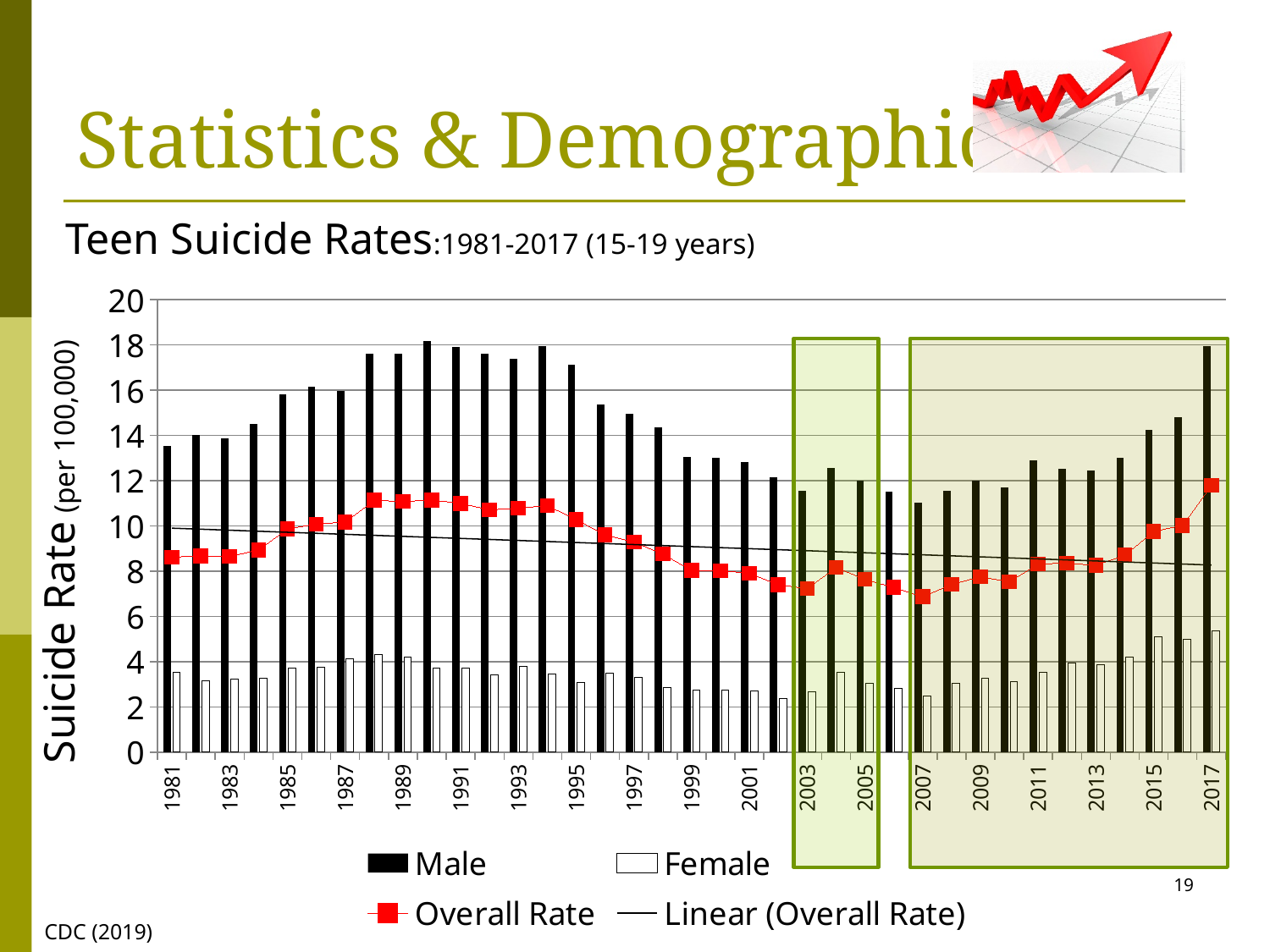
How many years are plotted along the x axis? 37 Is the Male value for 1981 greater or less than 12? greater What is the label on the y axis? Suicide Rate (per 100,000) Is the Overall Rate for 2007 greater or less than 8? less Does the Overall Rate rise or fall from 2007 to 2017? rise Which is larger, the Female value for 2017 or the Female value for 2002? 2017 Is the Female value for 1981 greater or less than 4? less Which is larger, the Male value for 1990 or the Male value for 2007? 1990 How many series does the legend list? 4 What kind of chart is used to show the Male and Female teen suicide rates? Bar chart